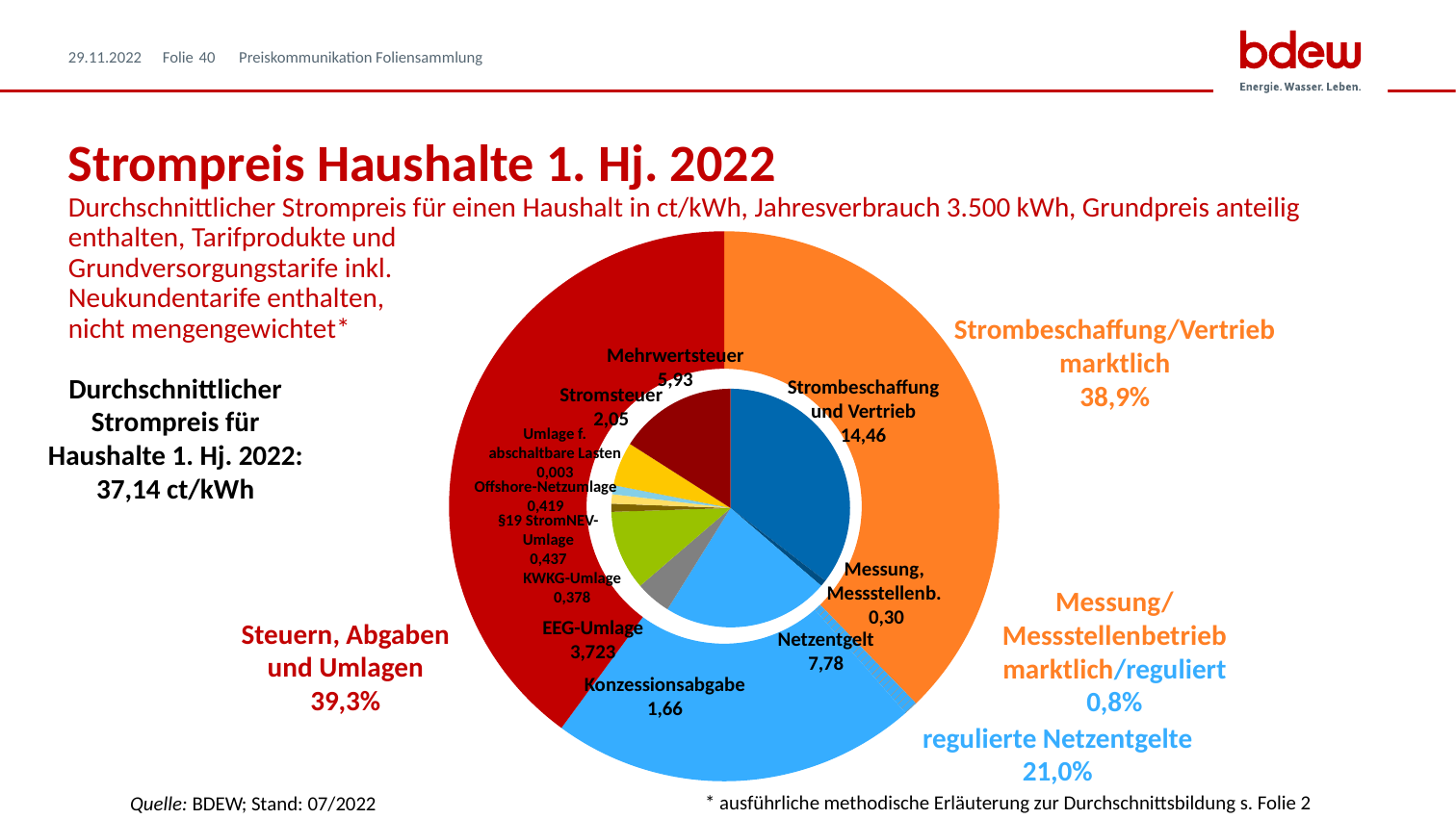
What is the difference between Strombeschaffung und Vertrieb (14,46) and Netzentgelt (7,78)? 6,68 What share of the outer ring is regulierte Netzentgelte? 21,0% What is the value for EEG-Umlage? 3,723 Which is larger, Stromsteuer or Konzessionsabgabe? Stromsteuer What is the value for Netzentgelt? 7,78 Which component of the inner pie has the highest value? Strombeschaffung und Vertrieb Which component of the inner pie has the lowest value? Umlage f. abschaltbare Lasten What kind of chart is shown on the slide? Pie chart What share of the outer ring is Steuern, Abgaben und Umlagen? 39,3% What is the value for Strombeschaffung und Vertrieb in the inner pie? 14,46 What is the total average electricity price for households stated on the slide? 37,14 ct/kWh What is the value for Mehrwertsteuer? 5,93